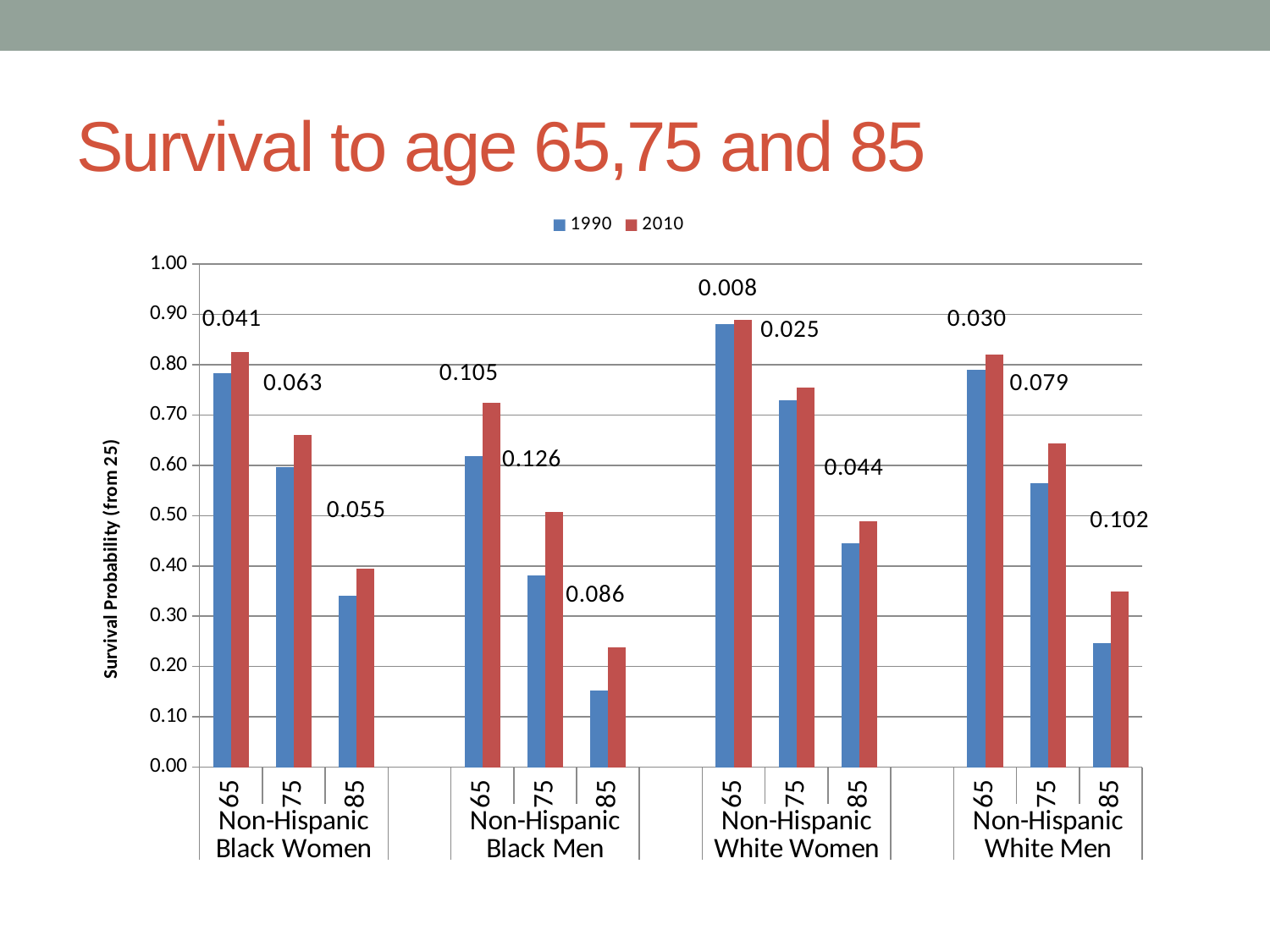
How many series does the legend list? 2 Is the 1990 value for age 85 among Non-Hispanic Black Men greater or less than 0.20? less Is the 2010 value for age 65 among Non-Hispanic White Women greater or less than 0.80? greater Which year's bars are shown in red in the legend? 2010 For age 75 among Non-Hispanic Black Men, which year has the larger value, 1990 or 2010? 2010 Is the 2010 value for age 85 among Non-Hispanic White Men greater or less than 0.40? less What is the title of the vertical axis? Survival Probability (from 25) Within each group, do the values rise or fall as age increases from 65 to 85? fall Which group and age has the lowest bar on the chart? Non-Hispanic Black Men, age 85 (1990) What kind of chart is shown on the slide? bar chart How many population groups are shown along the x axis? 4